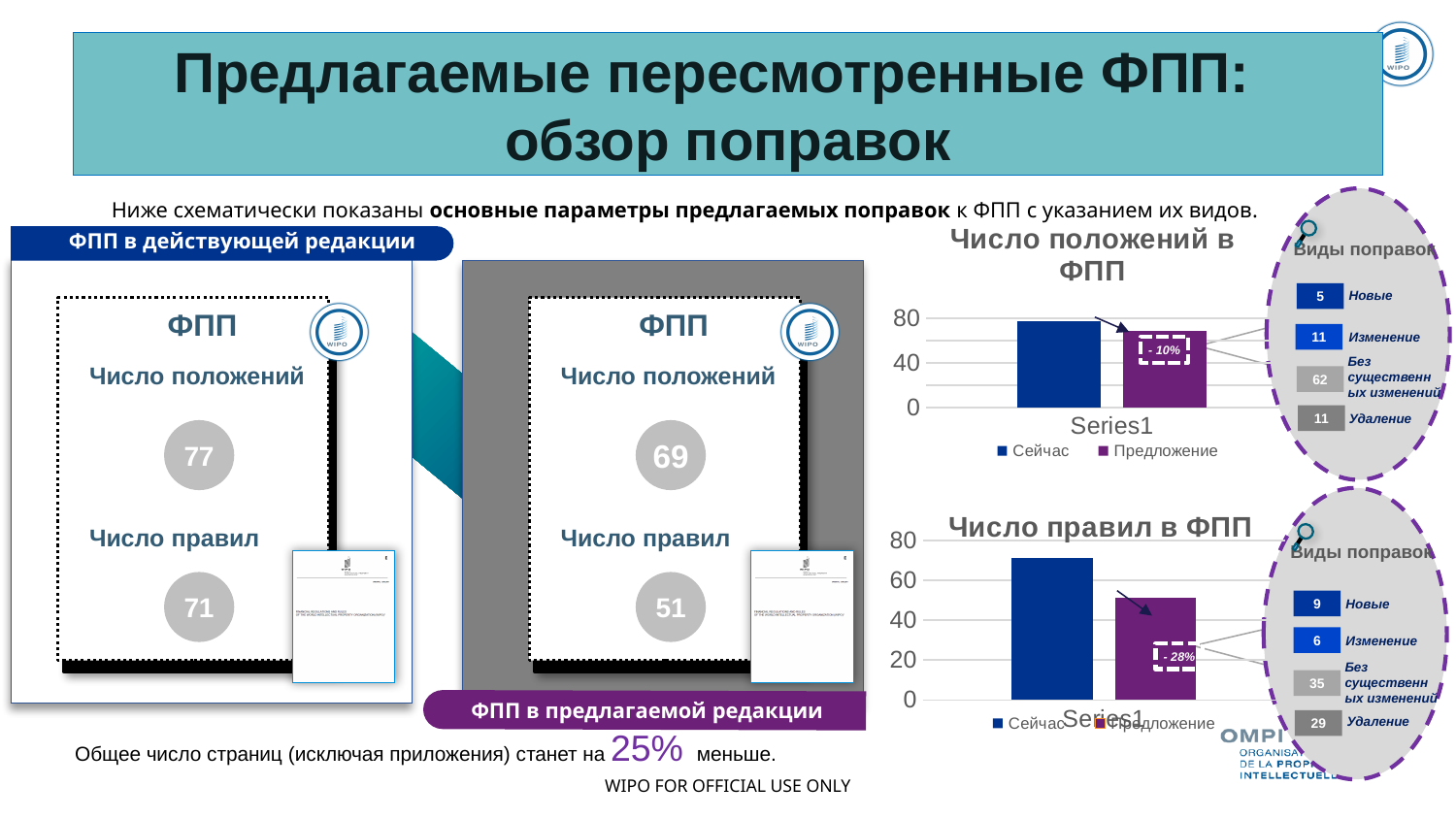
In the top chart "Число положений в ФПП", is the value for Сейчас greater or less than 40? greater In the bottom chart "Число правил в ФПП", what is the highest value shown on the vertical axis? 80 In the bottom chart "Число правил в ФПП", is the value for Предложение greater or less than 60? less In the top chart "Число положений в ФПП", what percentage label is shown on the Предложение bar? - 10% In the top chart "Число положений в ФПП", how many series does the legend list? 2 In the top chart "Число положений в ФПП", which bar is taller, Сейчас or Предложение? Сейчас In the bottom chart "Число правил в ФПП", is the value for Сейчас greater or less than 60? greater In the bottom chart "Число правил в ФПП", what percentage label is shown on the Предложение bar? - 28% What kind of chart is the top chart titled "Число положений в ФПП"? bar chart What kind of chart is the bottom chart titled "Число правил в ФПП"? bar chart In the bottom chart "Число правил в ФПП", which bar is taller, Сейчас or Предложение? Сейчас